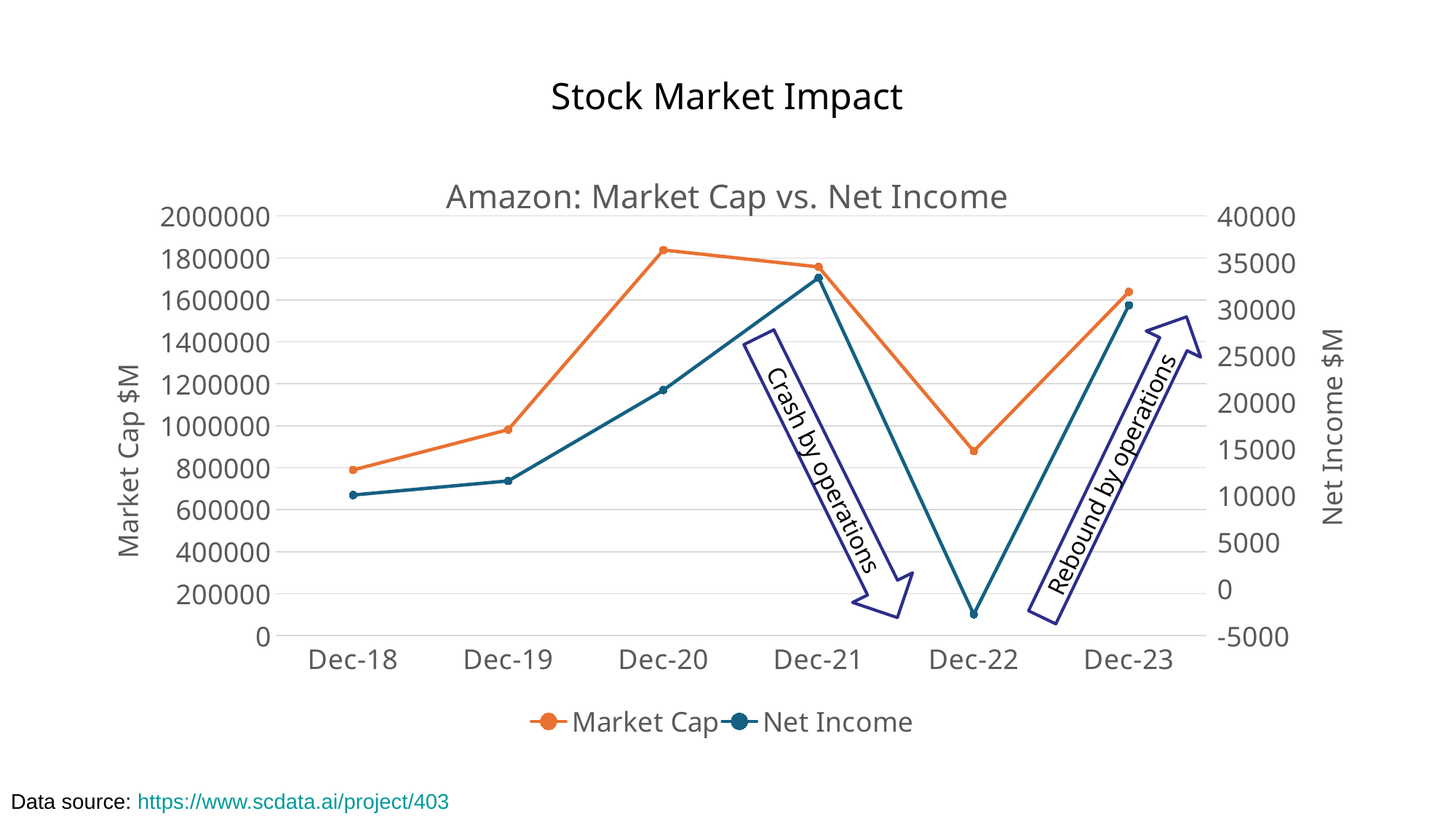
What kind of chart is shown on the slide? Line chart At which date is Market Cap highest? Dec-20 At which date is Net Income lowest? Dec-22 How many time points are plotted along the x axis? 6 At which date is Net Income highest? Dec-21 Is the Market Cap value for Dec-20 greater or less than 1600000? greater Does Market Cap rise or fall from Dec-18 to Dec-20? Rise Is the Market Cap value for Dec-22 greater or less than 1000000? less Is the Net Income value for Dec-22 greater or less than 0? less How many series does the legend list? 2 What is the label on the right-hand vertical axis? Net Income $M Which is larger, Market Cap at Dec-20 or Market Cap at Dec-22? Dec-20